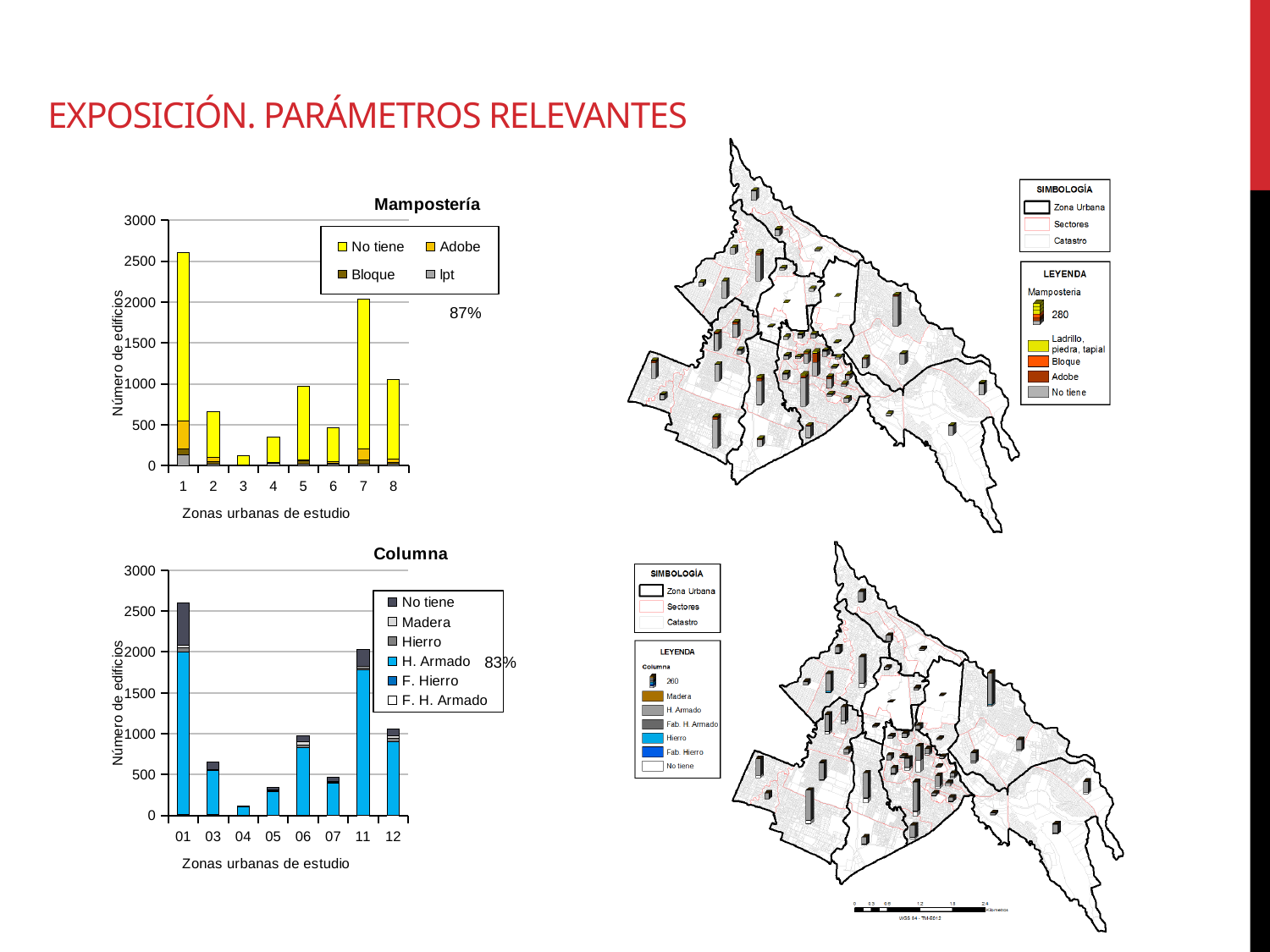
How many urban zones are shown on the x axis of the Mampostería chart? 8 In the Mampostería chart, is the total for zone 1 greater or less than 2500? greater In the Mampostería chart, which zone has a taller bar, zone 2 or zone 4? zone 2 What is the y-axis label of the Columna chart? Número de edificios In the Columna chart, which urban zone has the tallest bar? 01 How many series does the legend of the Columna chart list? 6 In the Mampostería chart, which urban zone has the tallest bar? 1 What kind of chart is the Mampostería chart? bar chart How many series does the legend of the Mampostería chart list? 4 In the Columna chart, is the total for zone 11 greater or less than 1500? greater In the Mampostería chart, is the total for zone 3 greater or less than 500? less In the Mampostería chart, which urban zone has the shortest bar? 3